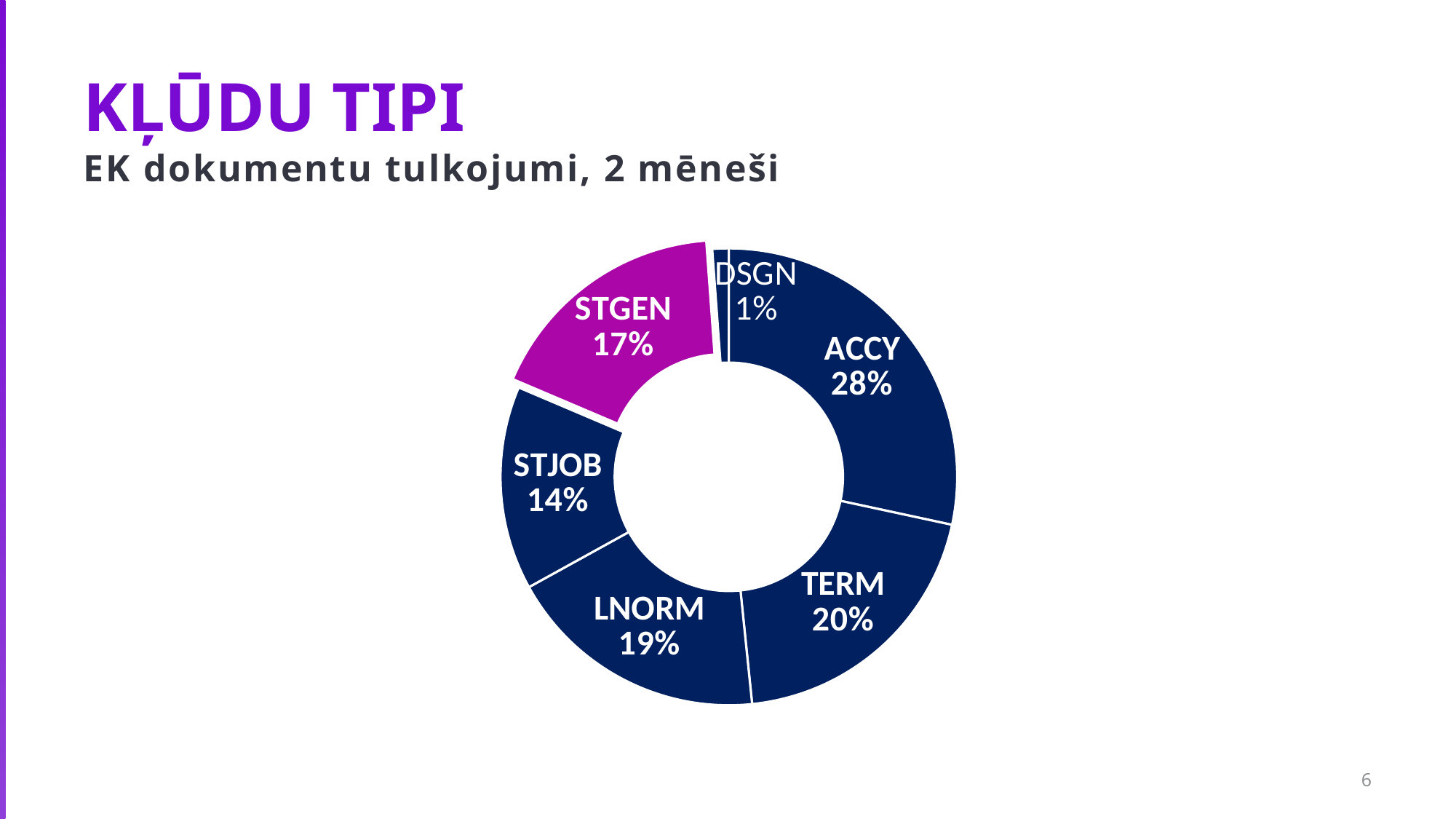
What is the value shown for STJOB? 14% Which is larger, the share for TERM or the share for STGEN? TERM Which category has the largest share of the chart? ACCY What kind of chart is shown on the slide? Doughnut (pie) chart Which category has the smallest share of the chart? DSGN Which category's slice is highlighted in a different colour (magenta) from the rest? STGEN What is the value shown for LNORM? 19% What is the difference in percentage points between ACCY and STJOB? 14 What is the value shown for STGEN? 17% How many categories are shown in the chart? 6 What is the value shown for TERM? 20% What share of the chart does ACCY account for? 28%